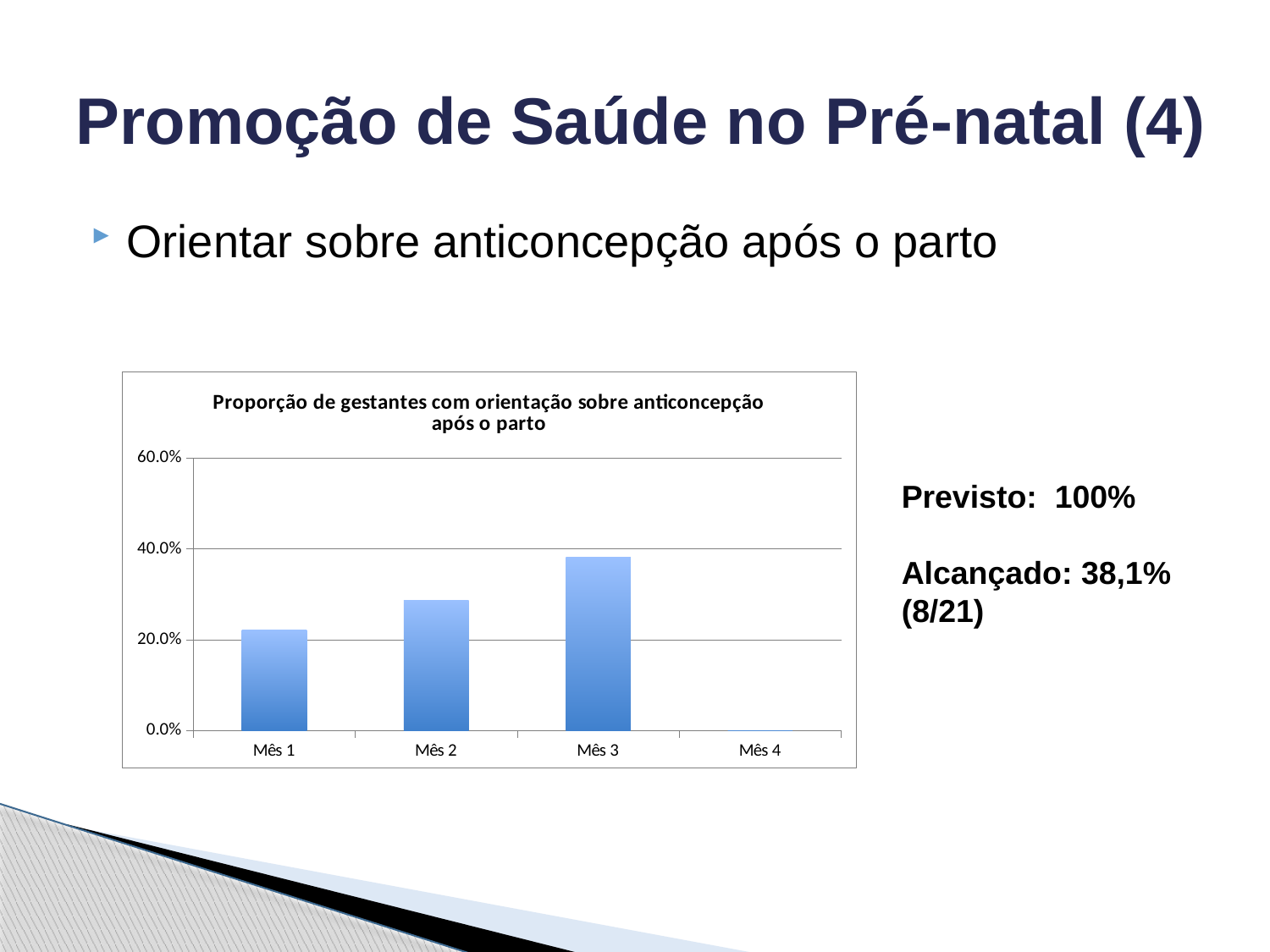
Among Mês 1, Mês 2 and Mês 3, which month has the lowest bar? Mês 1 How many month categories are shown on the x axis of the chart? 4 Which month category has no bar plotted in the chart? Mês 4 Do the values rise or fall from Mês 1 to Mês 3? rise Which is larger, the value for Mês 1 or the value for Mês 2? Mês 2 What is the highest value shown on the chart's vertical axis? 60.0% Which month has the highest bar in the chart? Mês 3 Is the value for Mês 2 greater or less than 40.0%? less Is the value for Mês 3 greater or less than 40.0%? less Is the value for Mês 2 greater or less than 20.0%? greater What kind of chart is shown on the slide? Bar chart Which is larger, the value for Mês 1 or the value for Mês 3? Mês 3